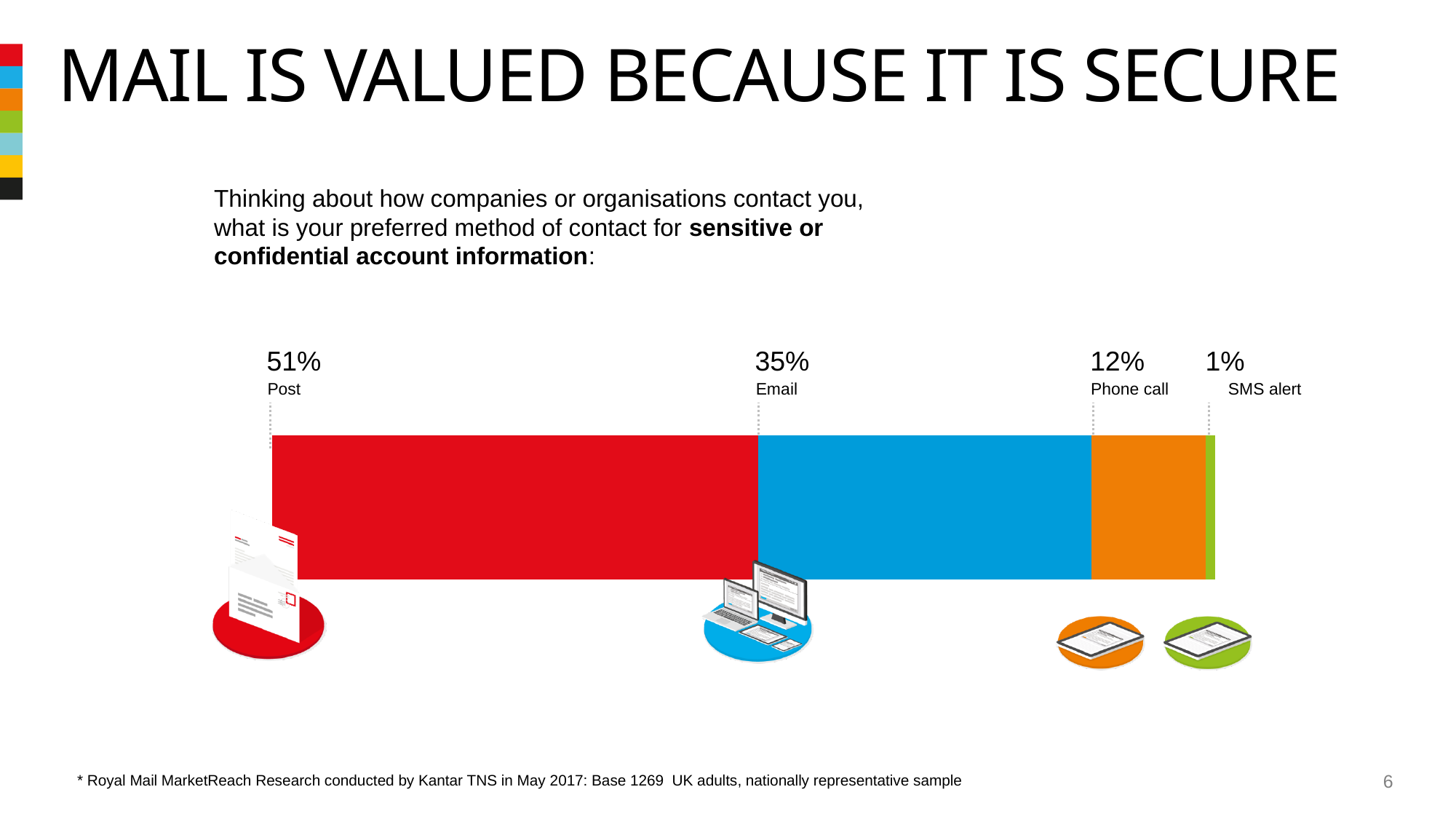
Which contact method has the highest share of preference? Post Which contact method has the lowest share of preference? SMS alert What colour is the segment representing Email? Blue What percentage of respondents prefer an SMS alert for sensitive or confidential account information? 1% How many contact methods are shown in the chart? 4 What is the difference in percentage points between Email and Phone call? 23 What is the combined percentage of Post and Email? 86% What percentage of respondents prefer a Phone call for sensitive or confidential account information? 12% What percentage of respondents prefer Post for sensitive or confidential account information? 51% Which is larger, the share for Post or the share for Email? Post What percentage of respondents prefer Email for sensitive or confidential account information? 35% What is the difference in percentage points between Post and Email? 16